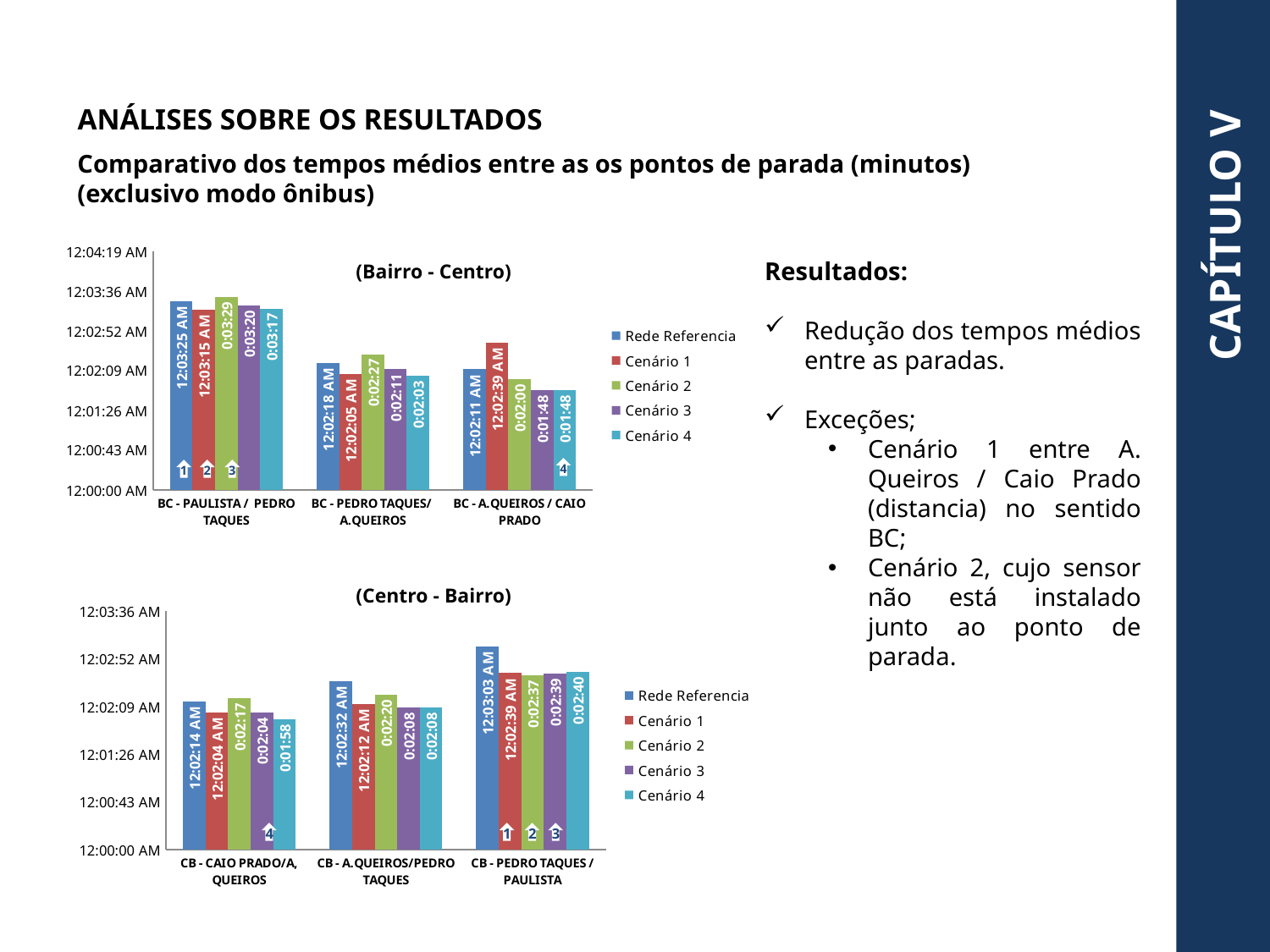
What kind of chart is the (Centro - Bairro) chart? Bar chart In the (Bairro - Centro) chart, what is the value for Rede Referencia at BC - PEDRO TAQUES/ A.QUEIROS? 12:02:18 AM In the (Bairro - Centro) chart, which series has the lowest value at BC - PEDRO TAQUES/ A.QUEIROS? Cenário 4 In the (Centro - Bairro) chart, which series has the highest value at CB - A.QUEIROS/PEDRO TAQUES? Rede Referencia How many categories are shown on the x axis of the (Bairro - Centro) chart? 3 How many series does the legend of the (Centro - Bairro) chart list? 5 In the (Bairro - Centro) chart, which is larger at BC - A.QUEIROS / CAIO PRADO: Cenário 1 or Cenário 2? Cenário 1 In the (Centro - Bairro) chart, what is the value for Rede Referencia at CB - PEDRO TAQUES / PAULISTA? 12:03:03 AM In the (Bairro - Centro) chart, what is the value for Cenário 2 at BC - PAULISTA / PEDRO TAQUES? 0:03:29 In the (Centro - Bairro) chart, what is the value for Cenário 4 at CB - CAIO PRADO/A, QUEIROS? 0:01:58 In the (Centro - Bairro) chart, what colour are the Cenário 2 bars? Green In the (Bairro - Centro) chart, what is the value for Cenário 1 at BC - A.QUEIROS / CAIO PRADO? 12:02:39 AM